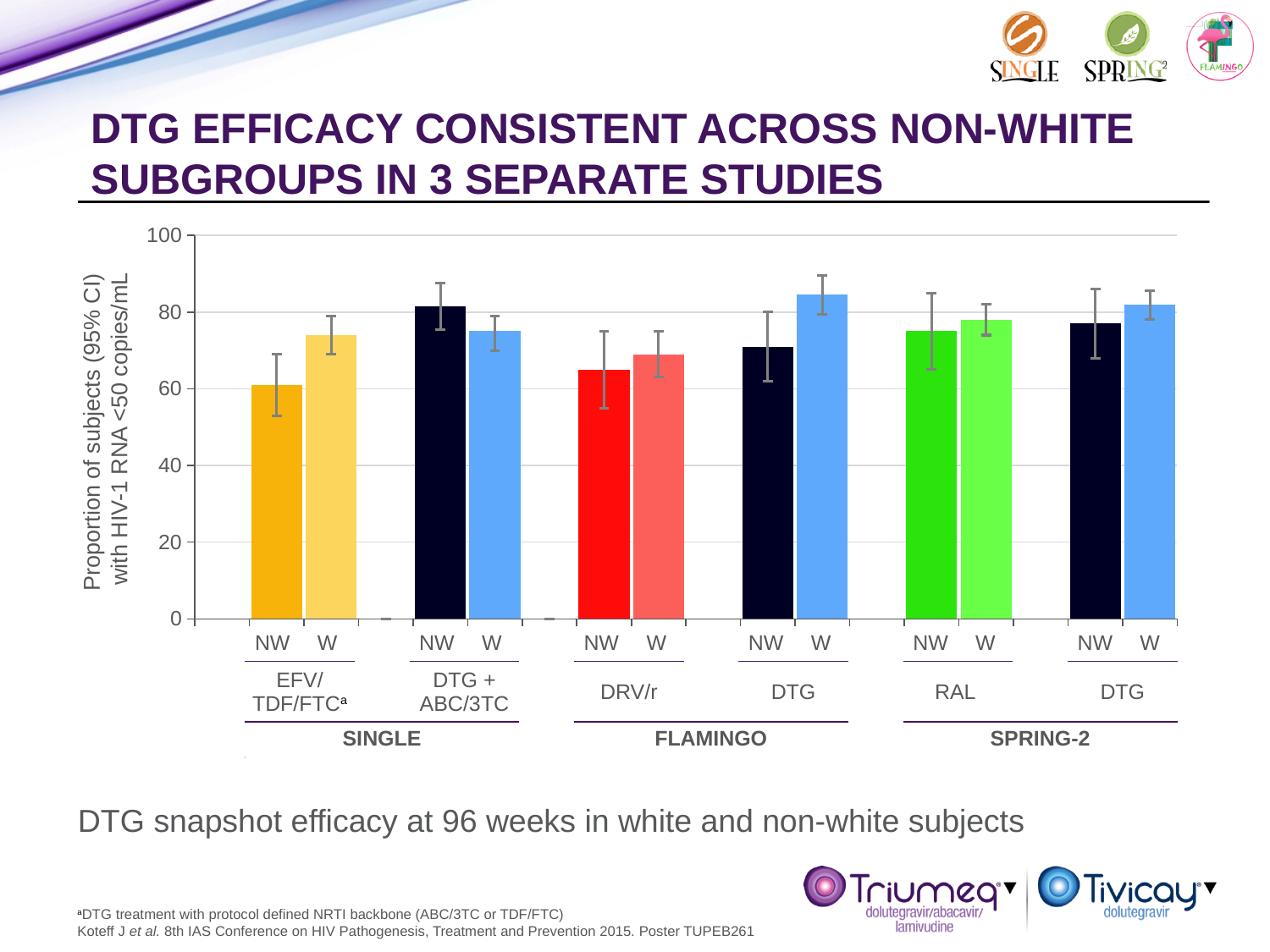
In the FLAMINGO study, is the value for DTG W greater or less than 80? greater In the SINGLE study, which is larger for EFV/TDF/FTC: the NW bar or the W bar? W In the FLAMINGO study, which is larger for DTG: the NW bar or the W bar? W How many bars are plotted in the chart? 12 In the SINGLE study, is the value for EFV/TDF/FTC NW greater or less than 80? less In the FLAMINGO study, is the value for DTG NW greater or less than 80? less What kind of chart is shown on the slide? bar chart How many studies are shown along the x axis of the chart? 3 What is the label of the y axis of the chart? Proportion of subjects (95% CI) with HIV-1 RNA <50 copies/mL Which bar has the lowest value in the chart? EFV/TDF/FTC NW (SINGLE) In the SINGLE study, which is larger for DTG + ABC/3TC: the NW bar or the W bar? NW